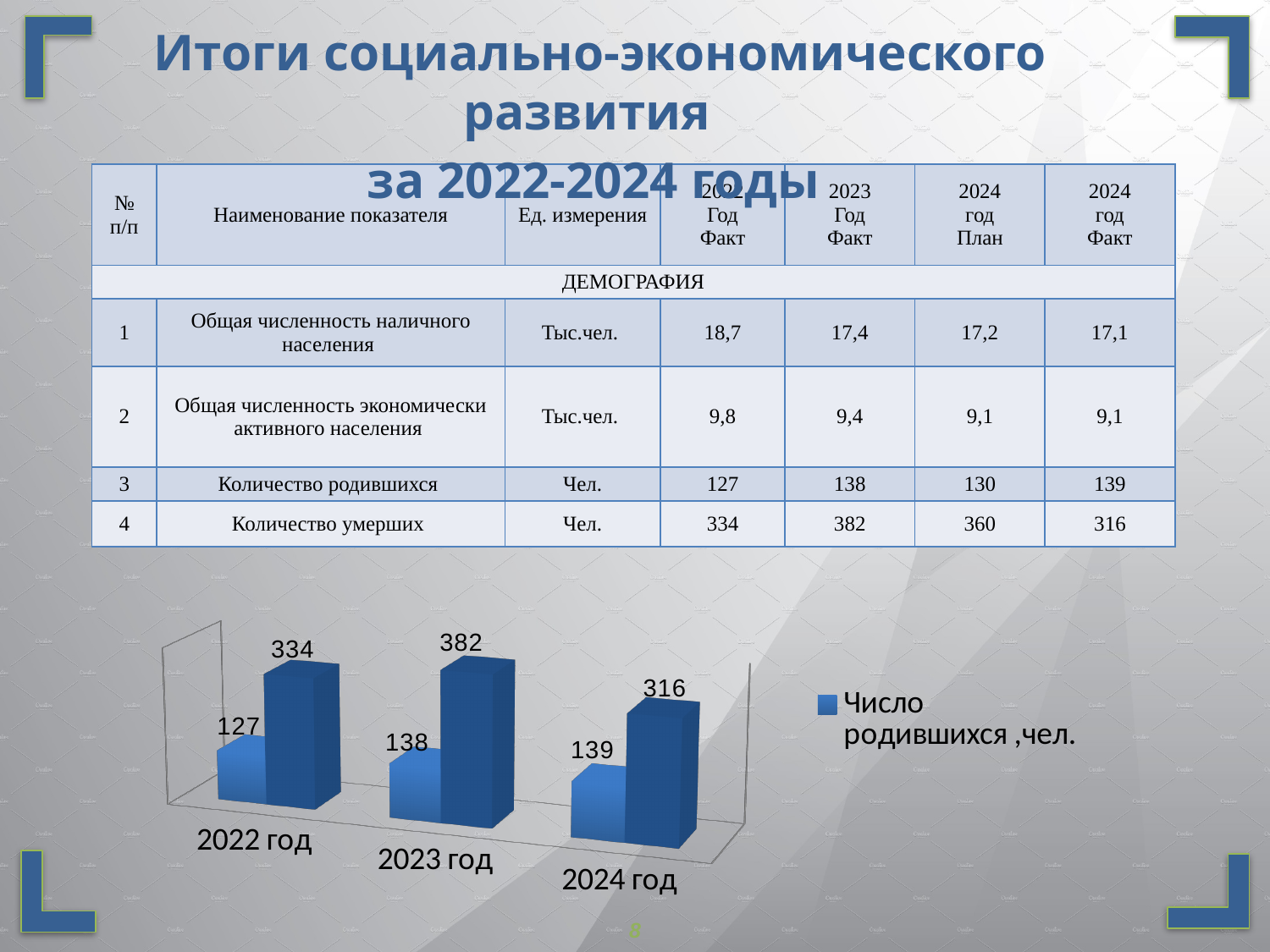
In which year is the darker blue bar the highest? 2023 год Which is larger for 2024 год: the 'Число родившихся' bar or the darker blue bar? the darker blue bar (316) What is the value of the 'Число родившихся, чел.' bar for 2023 год? 138 What is the value of the 'Число родившихся, чел.' bar for 2022 год? 127 What is the value of the darker blue bar for 2024 год? 316 What is the value of the 'Число родившихся, чел.' bar for 2024 год? 139 How many year categories are shown on the x axis of the chart? 3 In which year is the 'Число родившихся, чел.' bar the lowest? 2022 год What type of chart is shown on the slide? bar chart What is the value of the darker blue bar for 2023 год? 382 What is the difference between the darker blue bar and the 'Число родившихся' bar for 2022 год? 207 Do the 'Число родившихся, чел.' values rise or fall from 2022 год to 2024 год? rise